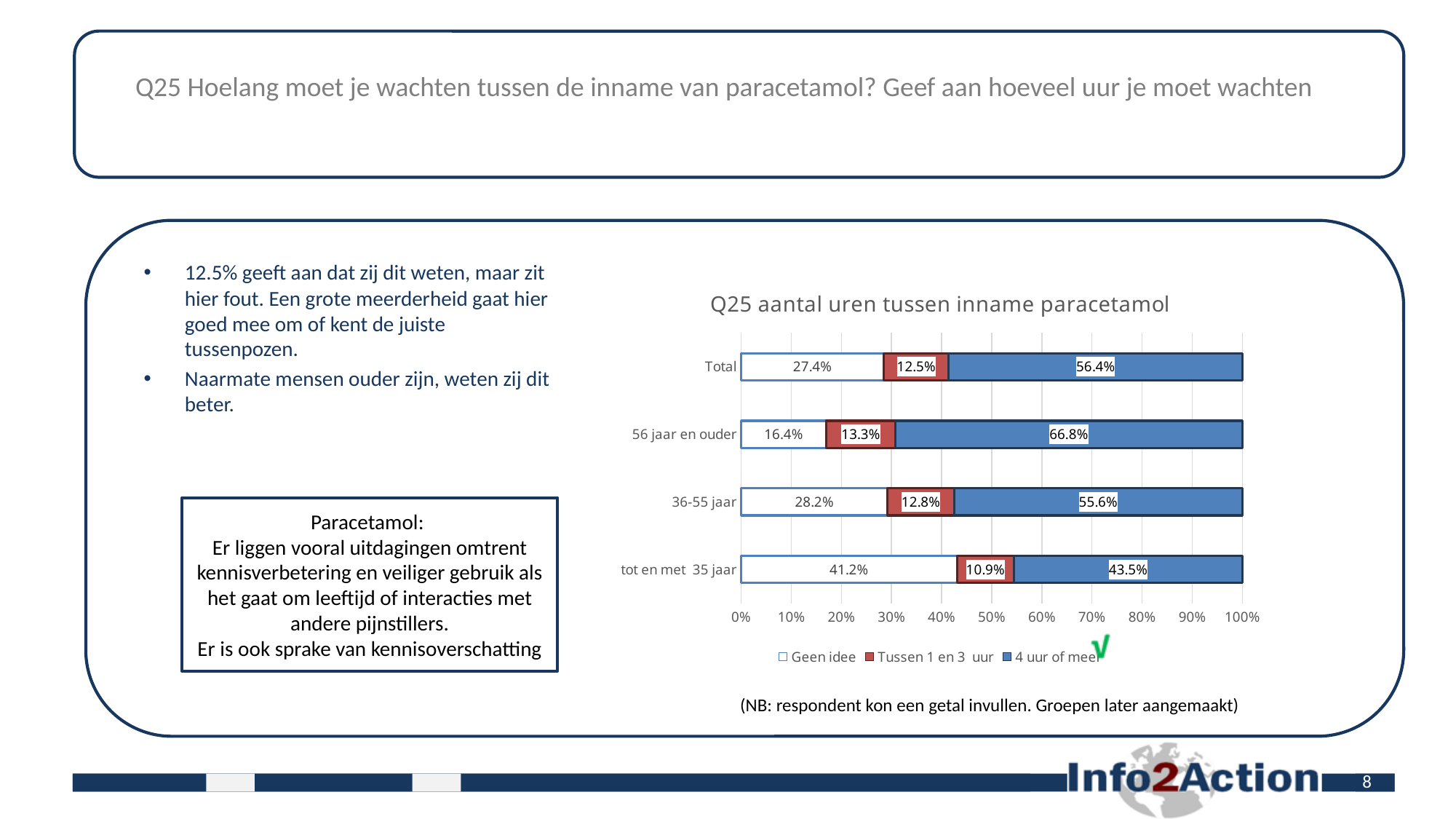
Which age group has the lowest value for 'Geen idee'? 56 jaar en ouder What is the title of the chart? Q25 aantal uren tussen inname paracetamol What type of chart is shown on the slide? Stacked bar chart What is the difference between the 'Geen idee' values for 'tot en met 35 jaar' and '56 jaar en ouder'? 24.8% What is the value for '4 uur of meer' for '56 jaar en ouder'? 66.8% What is the value for 'Geen idee' for '36-55 jaar'? 28.2% Which is larger: the '4 uur of meer' value for '36-55 jaar' or for 'tot en met 35 jaar'? 36-55 jaar How many series does the legend list? 3 How many categories (bars) are shown in the chart? 4 Which age group has the highest value for '4 uur of meer'? 56 jaar en ouder What is the value for 'Tussen 1 en 3 uur' for 'tot en met 35 jaar'? 10.9% What is the value for 'Geen idee' in the 'Total' bar? 27.4%